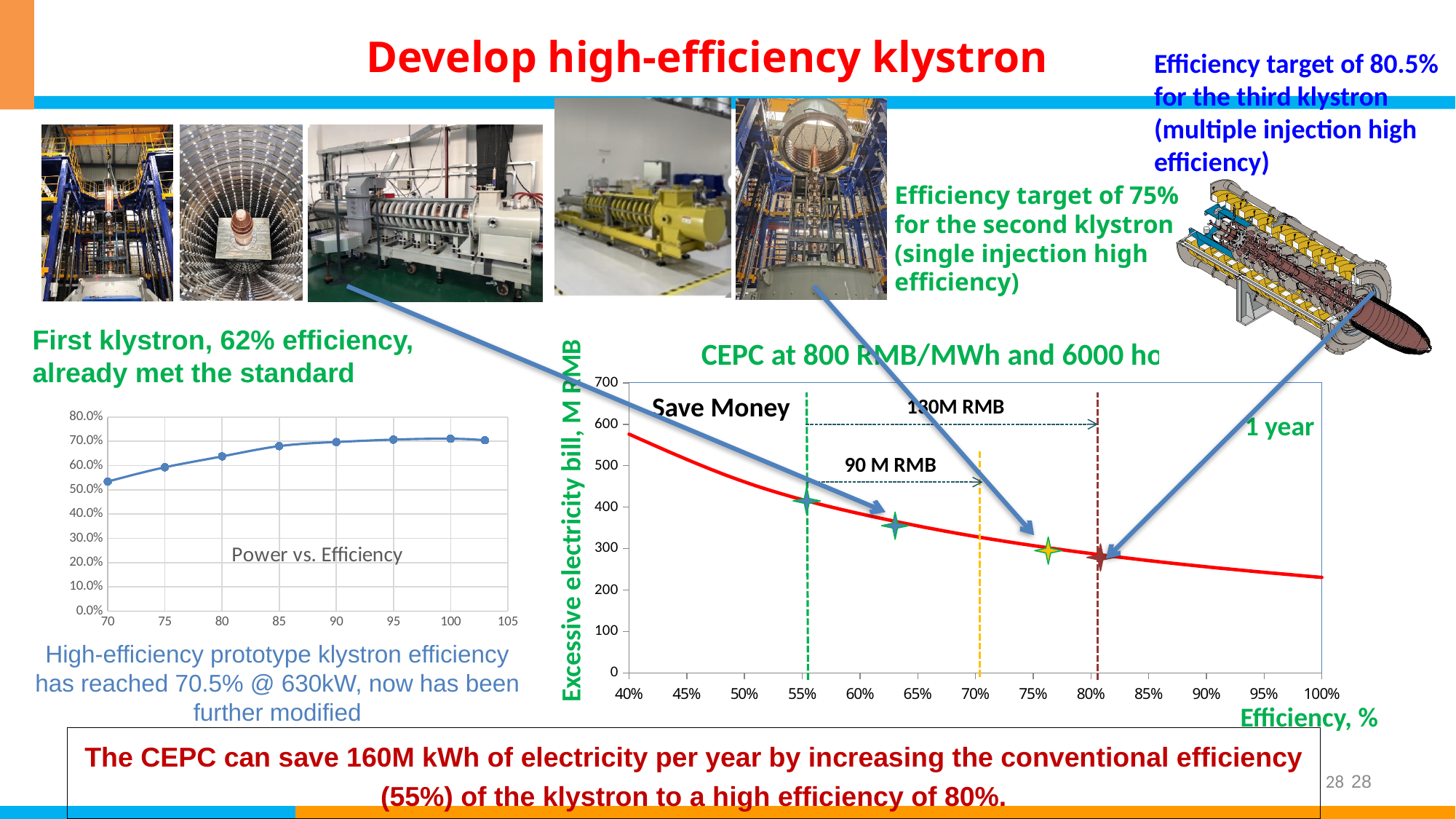
What type of chart is the left chart titled 'Power vs. Efficiency'? line chart In the left 'Power vs. Efficiency' chart, is the value at x = 90 greater or less than 60.0%? greater In the right CEPC chart, is the value of the red curve at 40% efficiency greater or less than 500? greater In the right CEPC chart, is the value of the red curve at 100% efficiency greater or less than 300? less What type of chart is the right chart titled 'CEPC at 800 RMB/MWh and 6000 ho...'? line chart In the left 'Power vs. Efficiency' chart, which x-axis value has the lowest plotted efficiency? 70 What is the maximum value shown on the y-axis of the left 'Power vs. Efficiency' chart? 80.0% What is the y-axis label of the right CEPC chart? Excessive electricity bill, M RMB In the left 'Power vs. Efficiency' chart, do the values generally rise or fall as x increases from 70 to 90? rise In the left 'Power vs. Efficiency' chart, how many data points are plotted? 8 In the right CEPC chart, does the excessive electricity bill rise or fall as efficiency increases? fall